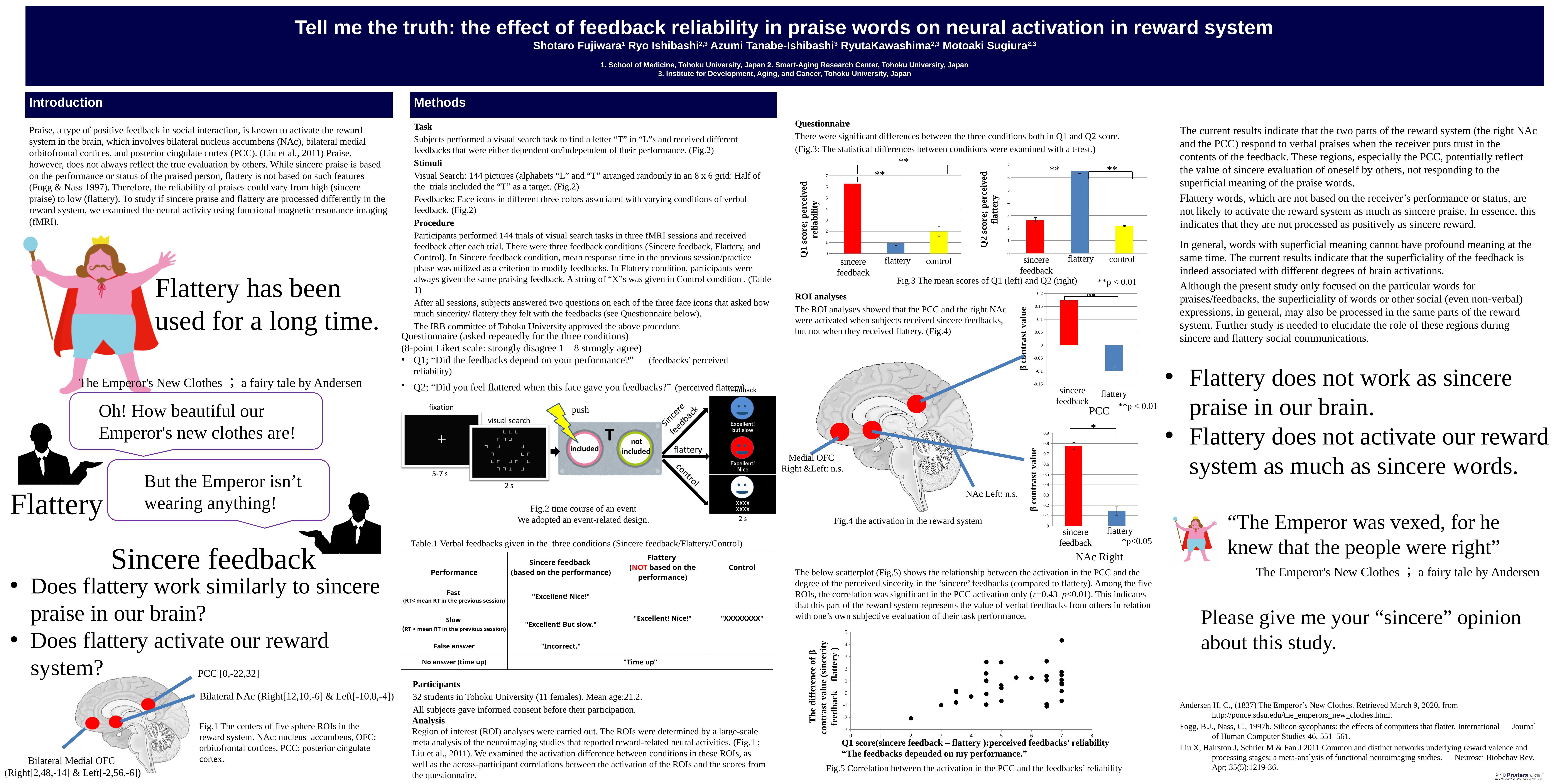
In the Q2 score (perceived flattery) chart of Fig.3, which is larger, the value for sincere feedback or the value for control? sincere feedback In the Q1 score (perceived reliability) chart of Fig.3, which condition has the lowest score? flattery What is the x-axis label of the Fig.5 scatterplot? Q1 score(sincere feedback – flattery ):perceived feedbacks' reliability In the PCC β contrast value chart, which condition has the higher β contrast value? sincere feedback In the Q2 score (perceived flattery) chart of Fig.3, is the value for flattery greater or less than 6? greater In the Q1 score (perceived reliability) chart of Fig.3, which condition has the highest score? sincere feedback What kind of chart is Fig.5, showing the correlation between PCC activation and feedback reliability? scatter plot How many conditions are plotted in the Q1 score chart of Fig.3? 3 In the PCC β contrast value chart, is the value for flattery greater or less than 0? less In the NAc Right β contrast value chart, is the value for sincere feedback greater or less than 0.7? greater In the Q2 score (perceived flattery) chart of Fig.3, which condition has the highest score? flattery